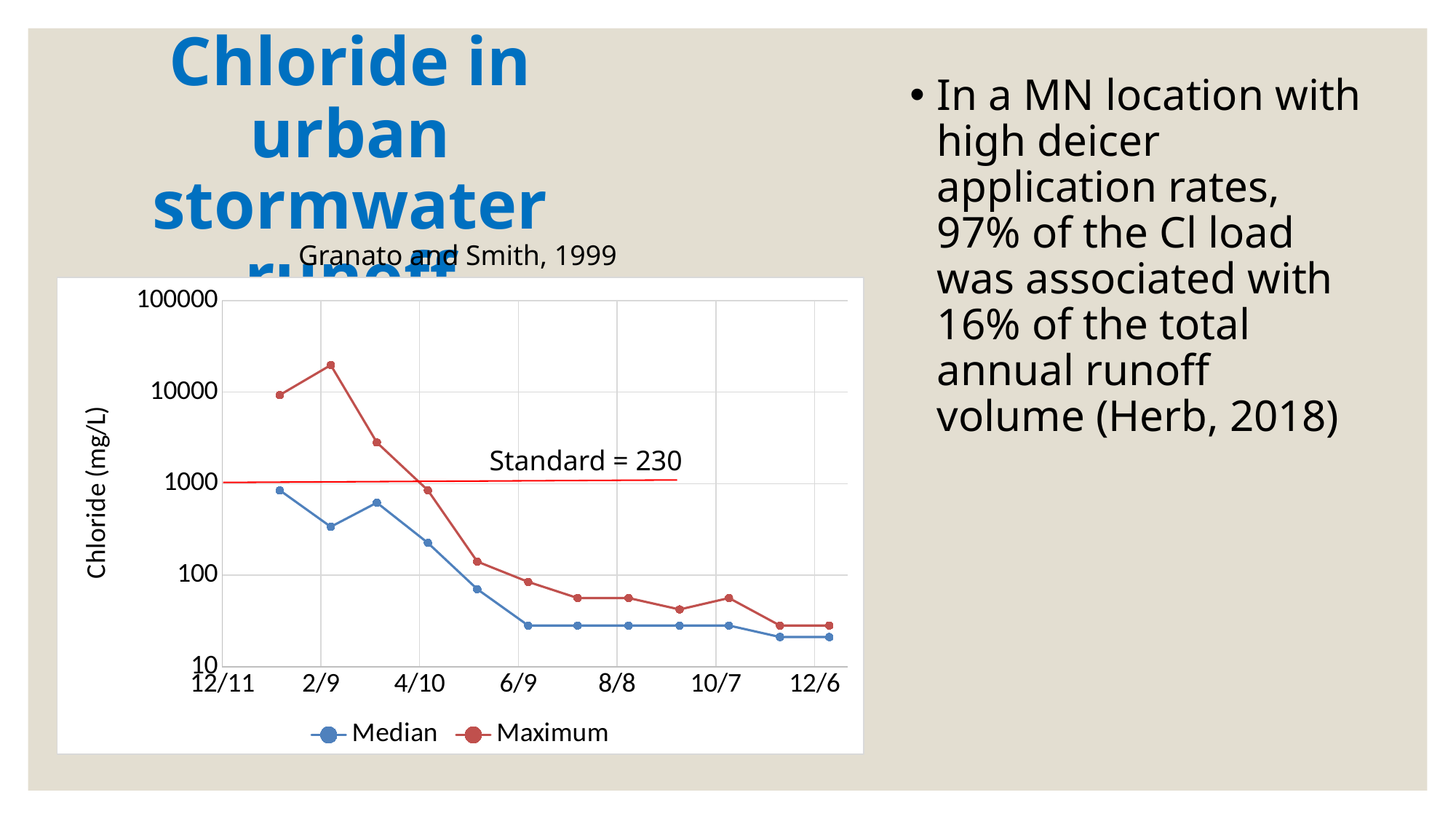
What value does the annotated standard line represent? Standard = 230 How many data points are plotted for the Maximum series? 12 Is the first plotted Median value greater or less than 1000? less How many series does the legend list? 2 Which series reaches the higher peak value, Median or Maximum? Maximum At the second plotted point (near 2/9), which series has the larger value, Median or Maximum? Maximum What are the two series named in the legend? Median and Maximum What is the label on the y-axis of the chart? Chloride (mg/L) Do the Median values generally rise or fall from left to right along the x axis? fall What kind of chart is shown on the slide? line chart Is the highest value of the Maximum series greater or less than 10000? greater Is the last plotted Maximum value greater or less than 100? less